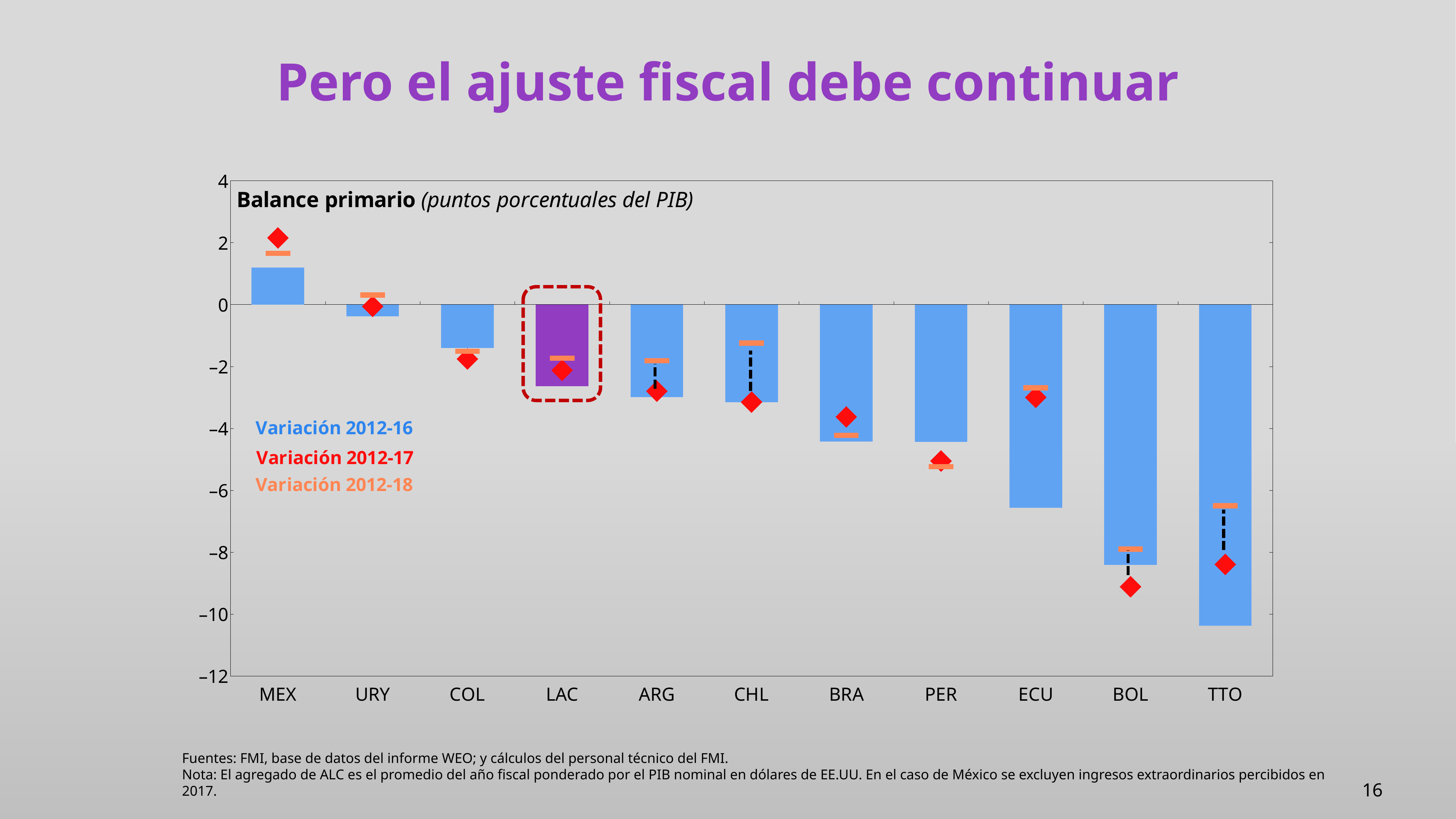
Which category's bar is highlighted in purple with a dashed red outline? LAC What kind of chart is shown on the slide? Bar chart Is the Variación 2012-16 bar for BOL greater or less than -8? less Do the Variación 2012-16 bars rise or fall moving from left to right along the x axis? fall Which category has the highest Variación 2012-16 bar? MEX Is the Variación 2012-17 marker for BOL greater or less than -8? less How many countries or regions are shown on the x axis of the chart? 11 Is the Variación 2012-16 bar for TTO greater or less than -10? less How many series does the chart's legend list? 3 Which category has the lowest Variación 2012-16 bar? TTO Which has the larger Variación 2012-16 value, COL or ARG? COL